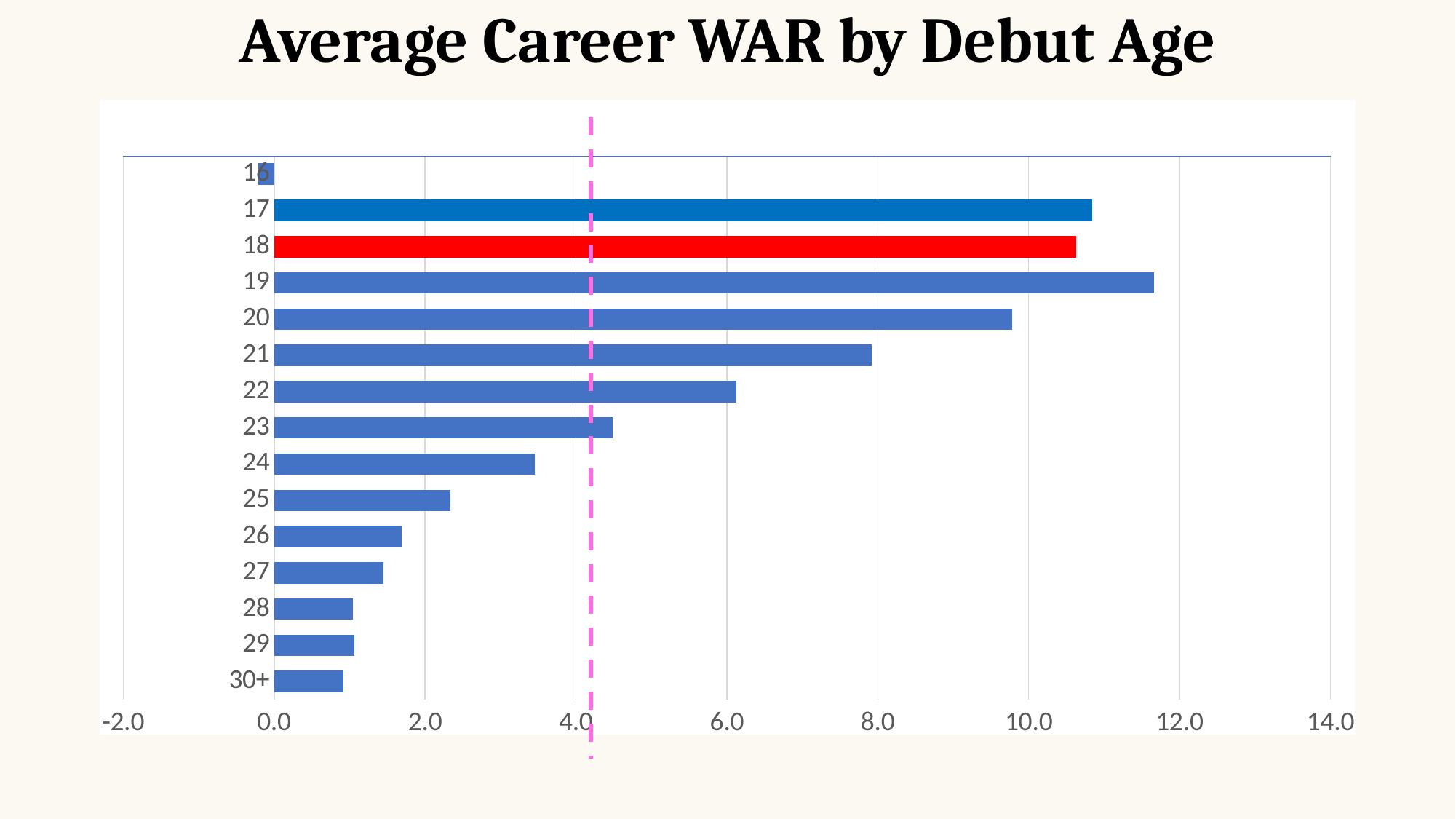
Which debut age has the lowest average career WAR? 16 Is the value for debut age 17 greater or less than 10.0? greater What is the title of the chart? Average Career WAR by Debut Age Which debut age's bar is coloured red? 18 Is the value for debut age 28 greater or less than 2.0? less How many debut age categories are plotted in the chart? 15 Which debut age has the highest average career WAR? 19 Going from debut age 19 down to 30+, do the average career WAR values rise or fall? fall Is the value for debut age 21 greater or less than 6.0? greater What kind of chart is shown on the slide? Bar chart Which has a higher average career WAR, debut age 19 or debut age 20? 19